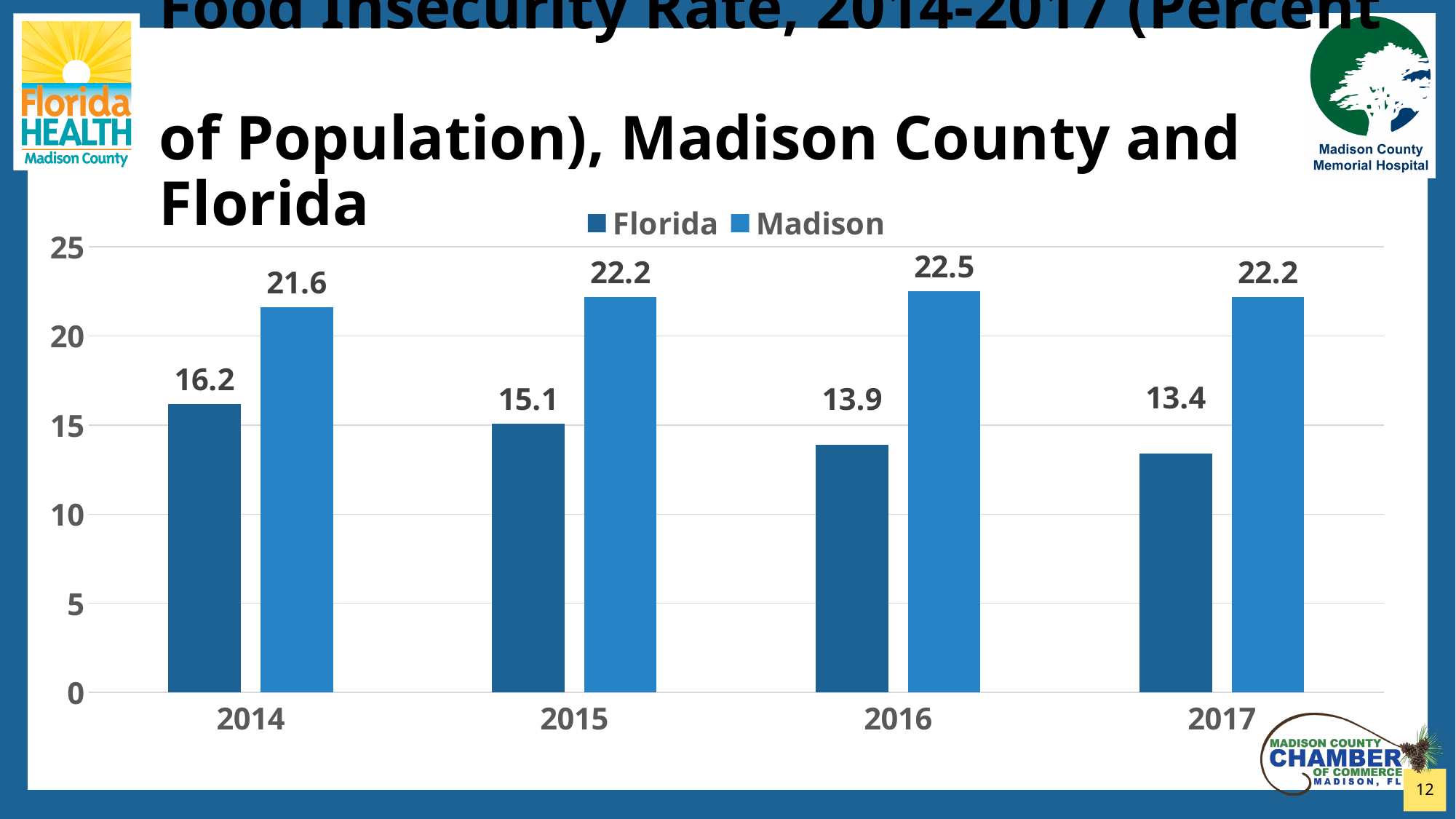
What is the food insecurity rate for Florida in 2017? 13.4 What is the difference between the Madison and Florida rates in 2015? 7.1 Does the Florida food insecurity rate rise or fall from 2014 to 2017? fall What kind of chart is shown on the slide? bar chart In which year is the Madison food insecurity rate highest? 2016 What is the food insecurity rate for Florida in 2014? 16.2 How many years are shown on the x axis? 4 In which year is the Florida food insecurity rate lowest? 2017 Is the Florida value for 2016 greater or less than 15? less How many series does the legend list? 2 Which is larger in 2014, the Florida rate or the Madison rate? Madison What is the food insecurity rate for Madison in 2016? 22.5